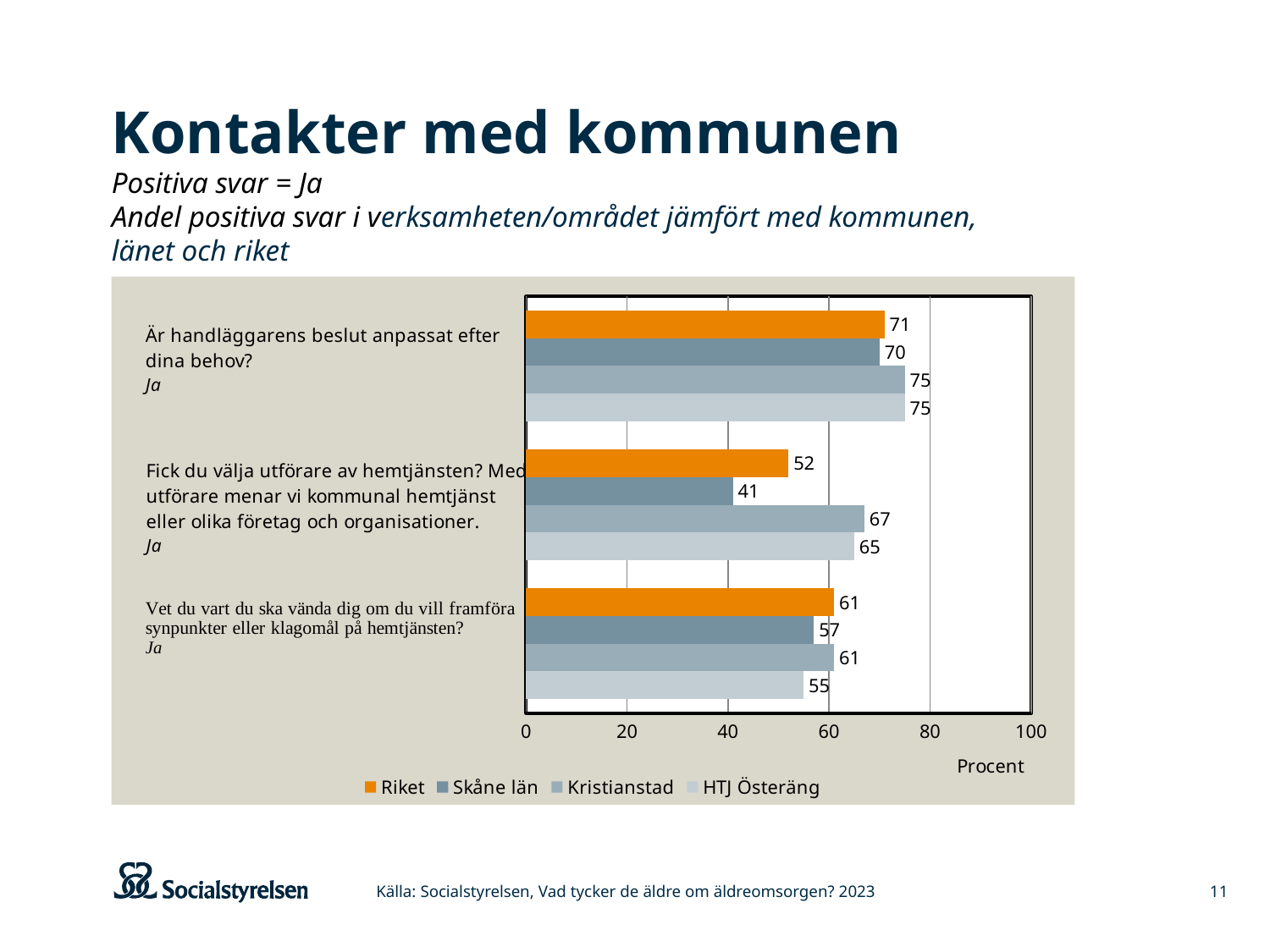
What is the label on the horizontal axis of the chart? Procent What is the value for Riket on the question "Är handläggarens beslut anpassat efter dina behov?"? 71 What is the value for HTJ Österäng on the question "Vet du vart du ska vända dig om du vill framföra synpunkter eller klagomål på hemtjänsten?"? 55 What is the difference between Kristianstad and Skåne län on the question "Fick du välja utförare av hemtjänsten?"? 26 Which series has the highest value on the question "Vet du vart du ska vända dig om du vill framföra synpunkter eller klagomål på hemtjänsten?"? Riket and Kristianstad (both 61) How many series does the legend list? 4 Which series has the lowest value on the question "Fick du välja utförare av hemtjänsten?"? Skåne län What kind of chart is shown on the slide? bar chart Is the value for Skåne län on the question "Fick du välja utförare av hemtjänsten?" greater or less than 60? less How many questions (categories) are plotted on the chart? 3 What is the value for Skåne län on the question "Fick du välja utförare av hemtjänsten?"? 41 Which is larger on the question "Är handläggarens beslut anpassat efter dina behov?": Riket or Kristianstad? Kristianstad